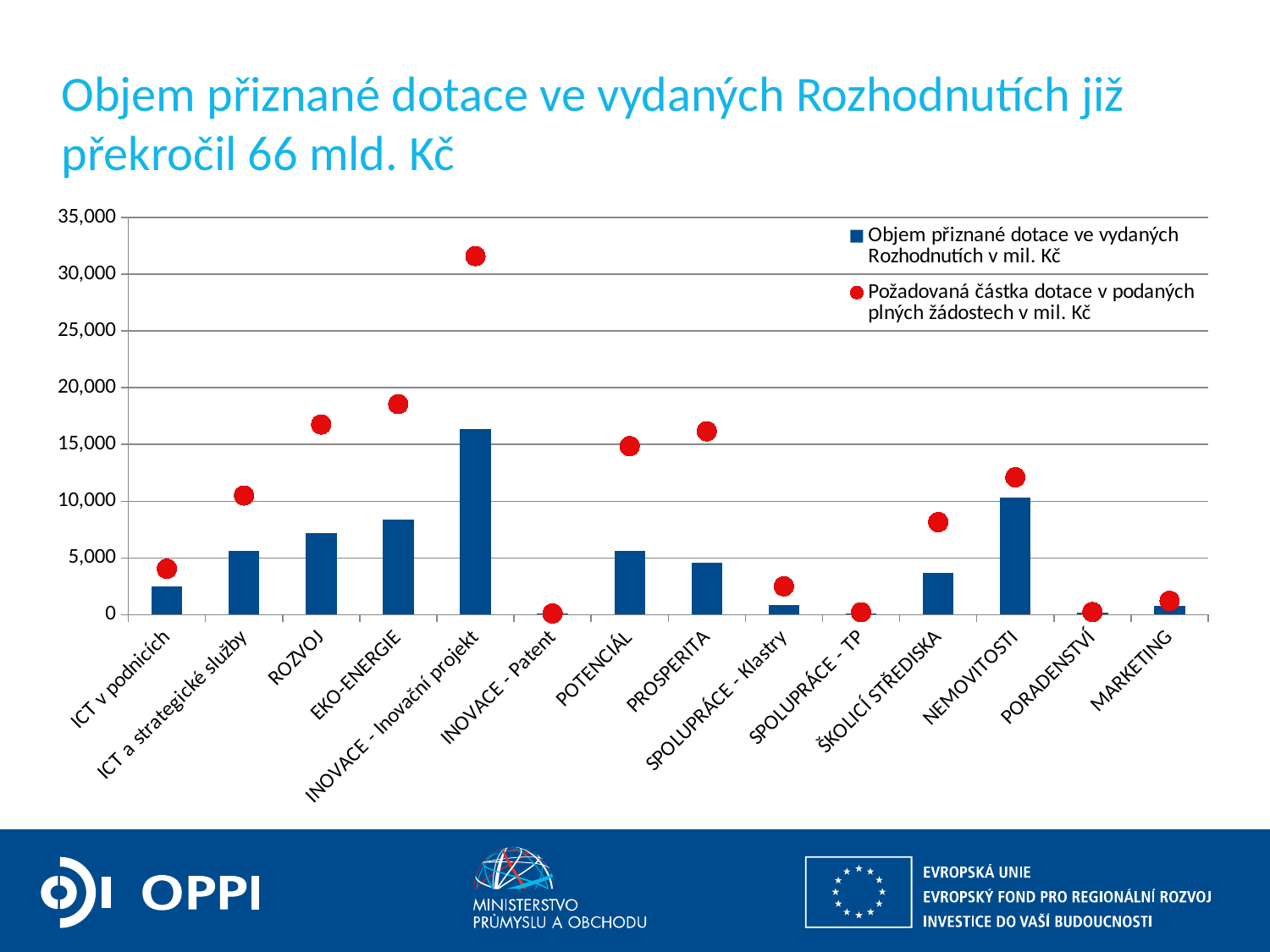
How many categories are shown on the x axis of the chart? 14 Is the 'Požadovaná částka dotace' value for EKO-ENERGIE greater or less than 20,000? less Is the 'Požadovaná částka dotace' value for INOVACE - Inovační projekt greater or less than 30,000? greater How many series does the chart legend list? 2 What type of chart is used to plot the series 'Objem přiznané dotace ve vydaných Rozhodnutích v mil. Kč'? bar chart Is the bar value for ROZVOJ greater or less than 5,000? greater What colour are the markers for 'Požadovaná částka dotace v podaných plných žádostech v mil. Kč'? red Which has the larger bar for 'Objem přiznané dotace', NEMOVITOSTI or ŠKOLICÍ STŘEDISKA? NEMOVITOSTI Which category has the highest bar for 'Objem přiznané dotace ve vydaných Rozhodnutích v mil. Kč'? INOVACE - Inovační projekt Which category has the highest value for 'Požadovaná částka dotace v podaných plných žádostech v mil. Kč'? INOVACE - Inovační projekt